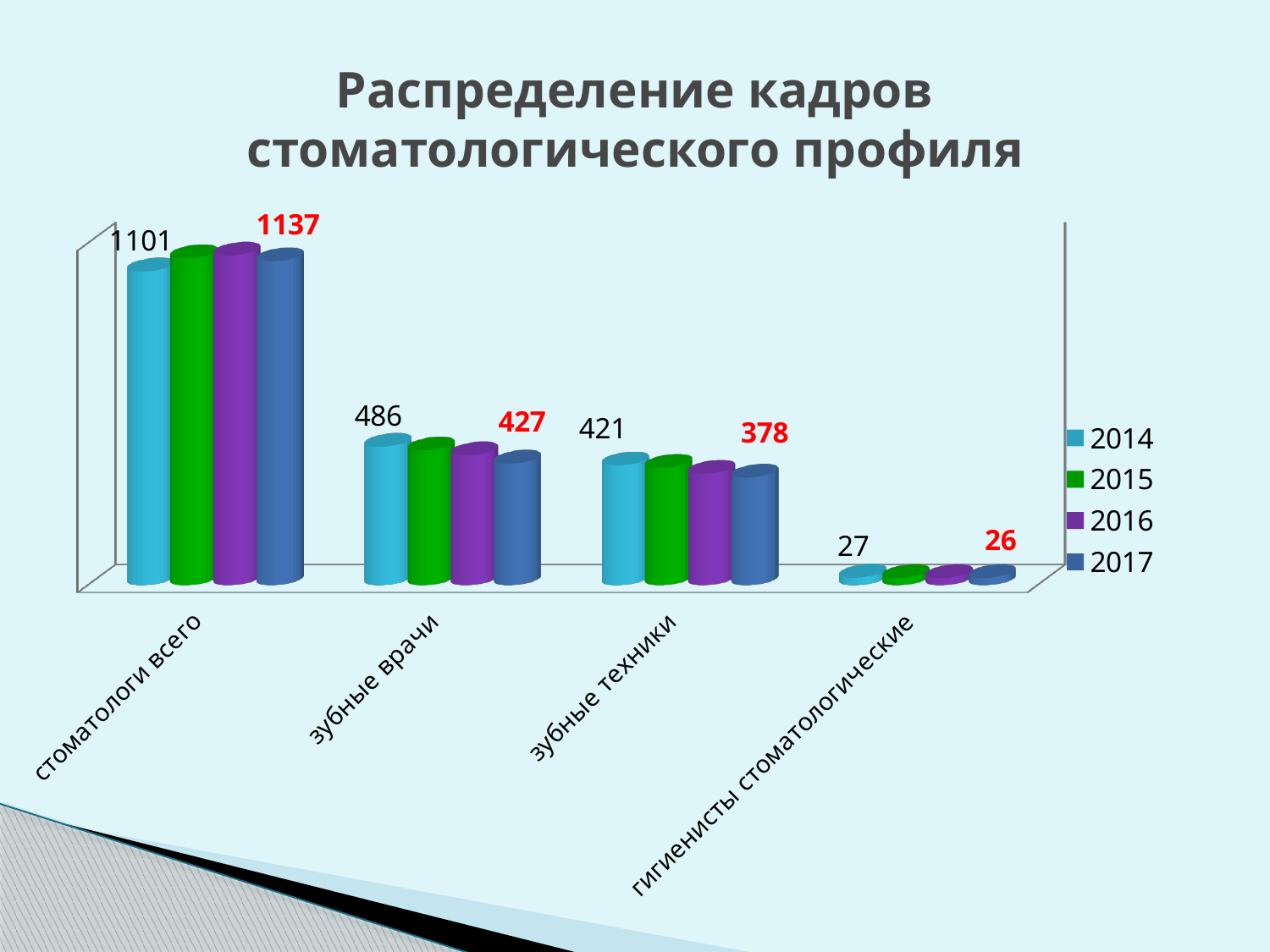
What is the value for зубные техники in 2017? 378 Which category has the lowest values in the chart? гигиенисты стоматологические What is the value for гигиенисты стоматологические in 2014? 27 What is the value for стоматологи всего in 2017? 1137 Which is larger: the 2014 value for зубные врачи or the 2014 value for зубные техники? зубные врачи What is the value for стоматологи всего in 2014? 1101 What is the value for зубные врачи in 2014? 486 How many series does the legend list? 4 Which category has the highest values in the chart? стоматологи всего What kind of chart is shown on the slide? bar chart What is the difference between the 2014 and 2017 values for зубные врачи? 59 What is the difference between the 2017 and 2014 values for стоматологи всего? 36